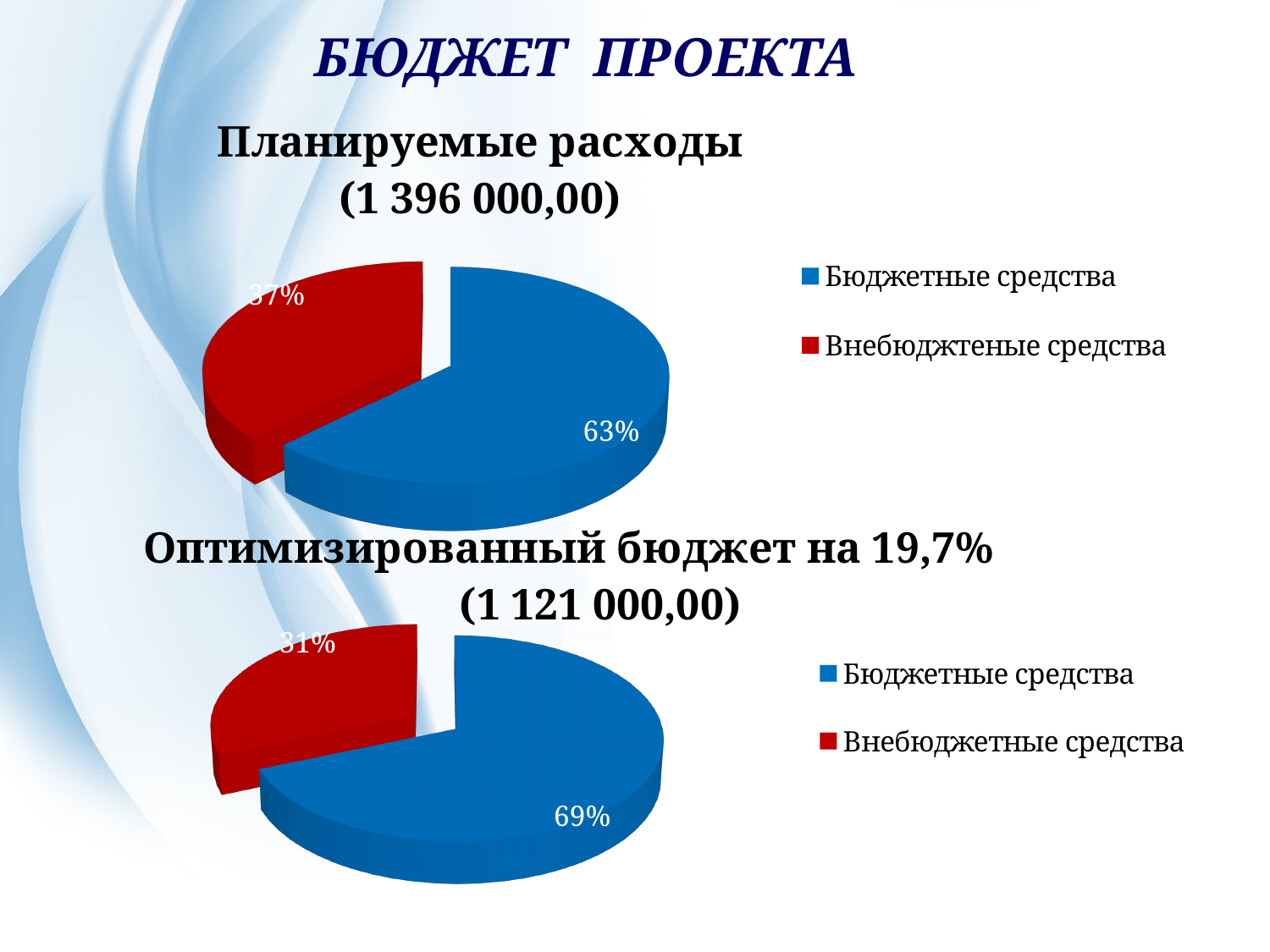
In the bottom chart (Оптимизированный бюджет), what is the difference in percentage points between the Бюджетные средства slice and the Внебюджетные средства slice? 38 In the bottom chart (Оптимизированный бюджет), what share of the pie is Бюджетные средства? 69% In the bottom chart (Оптимизированный бюджет), what share of the pie is Внебюджетные средства? 31% Which chart has the larger share for Бюджетные средства, the top chart or the bottom chart? the bottom chart What kind of chart is the top chart (Планируемые расходы)? pie chart In the top chart (Планируемые расходы), what is the difference in percentage points between the Бюджетные средства slice and the Внебюджтеные средства slice? 26 How many slices does the bottom chart (Оптимизированный бюджет) have? 2 In the top chart (Планируемые расходы), what share of the pie is Бюджетные средства? 63% In the top chart (Планируемые расходы), which category has the largest slice? Бюджетные средства In the top chart (Планируемые расходы), what colour is the Внебюджтеные средства slice? red In the bottom chart (Оптимизированный бюджет), which category has the smallest slice? Внебюджетные средства